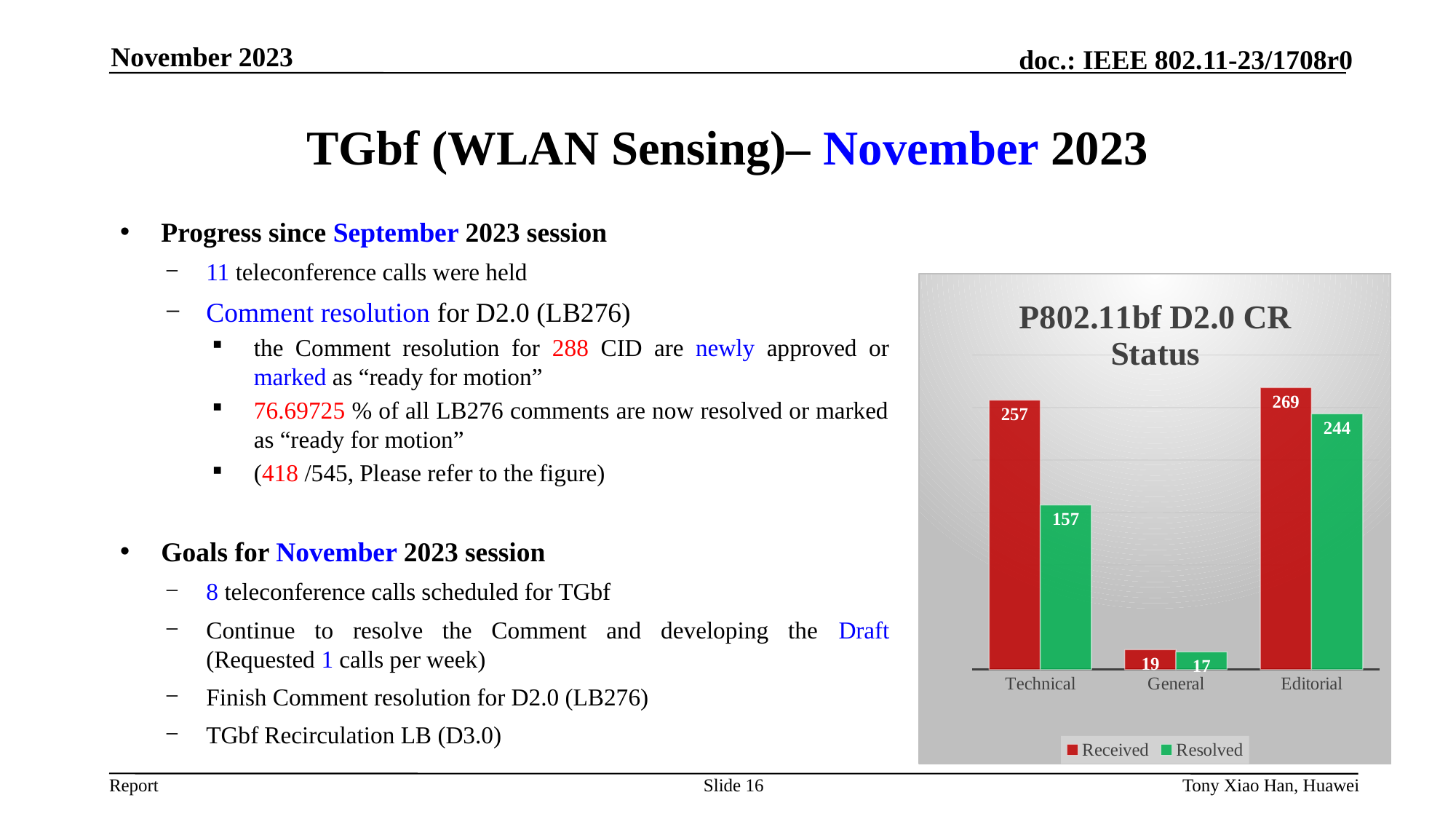
How many categories are shown on the x axis? 3 What kind of chart is shown? bar chart What is the Resolved value for General? 17 Which category has the lowest Resolved value? General What is the difference between Received and Resolved for Editorial? 25 What is the Resolved value for Editorial? 244 Which category has the highest Received value? Editorial What is the difference between Received and Resolved for Technical? 100 What is the title of the chart? P802.11bf D2.0 CR Status What is the Received value for Technical? 257 Which is larger, the Resolved value for Technical or the Resolved value for Editorial? Editorial How many series does the legend list? 2